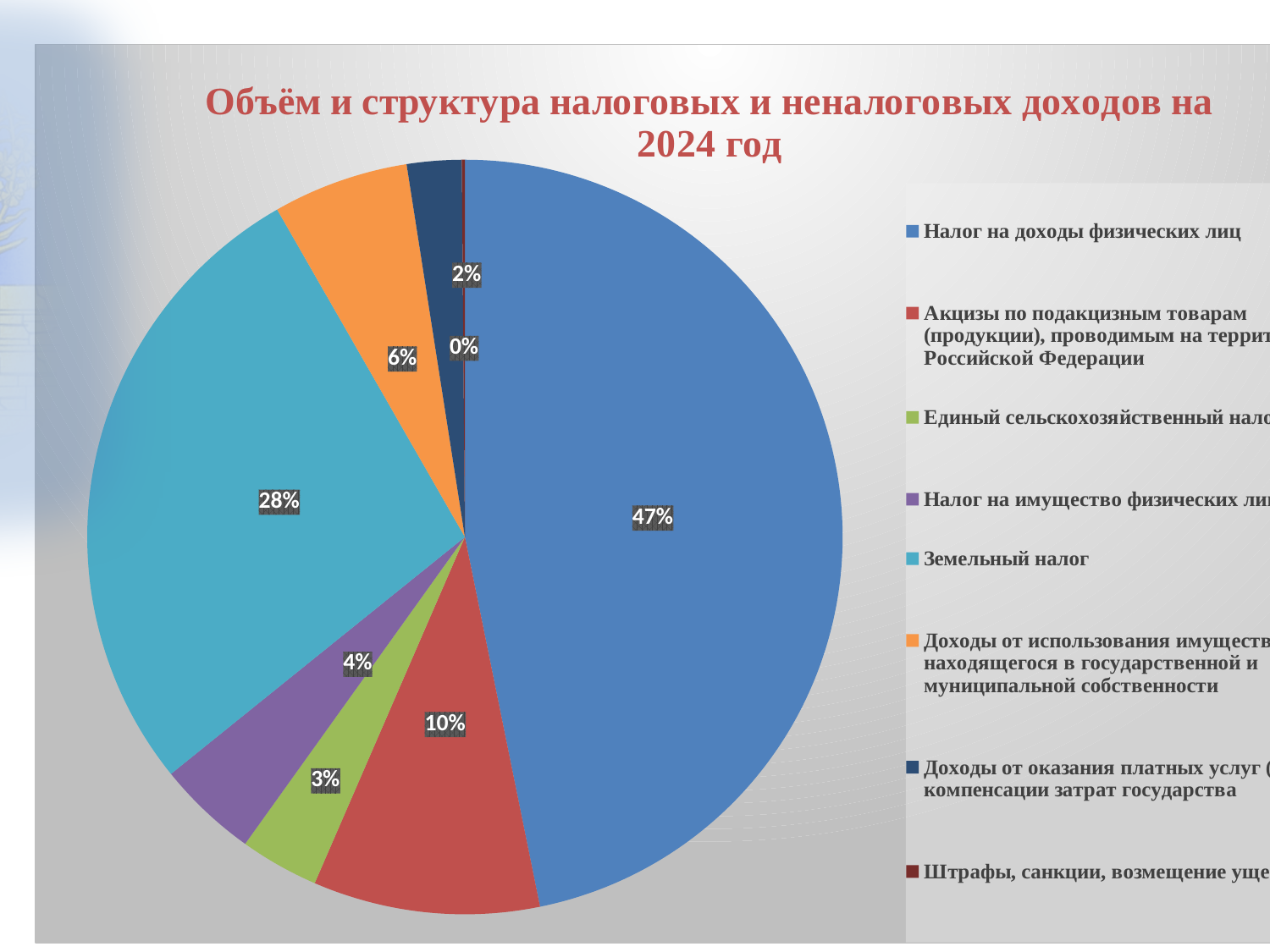
What percentage is shown for Доходы от оказания платных услуг и компенсации затрат государства? 2% What type of chart is shown on the slide? Pie chart Which is larger: the share for Земельный налог or the share for Акцизы по подакцизным товарам? Земельный налог What percentage is shown for Земельный налог? 28% What is the title of the chart? Объём и структура налоговых и неналоговых доходов на 2024 год What share is shown for Доходы от использования имущества, находящегося в государственной и муниципальной собственности? 6% By how many percentage points does Налог на доходы физических лиц exceed Земельный налог? 19 percentage points What is the difference between the shares of Акцизы по подакцизным товарам and Доходы от использования имущества? 4 percentage points How many slices does the pie chart have? 8 What percentage is shown for Акцизы по подакцизным товарам (продукции)? 10% Which category has the largest slice of the pie? Налог на доходы физических лиц What share of the pie does Налог на доходы физических лиц represent? 47%